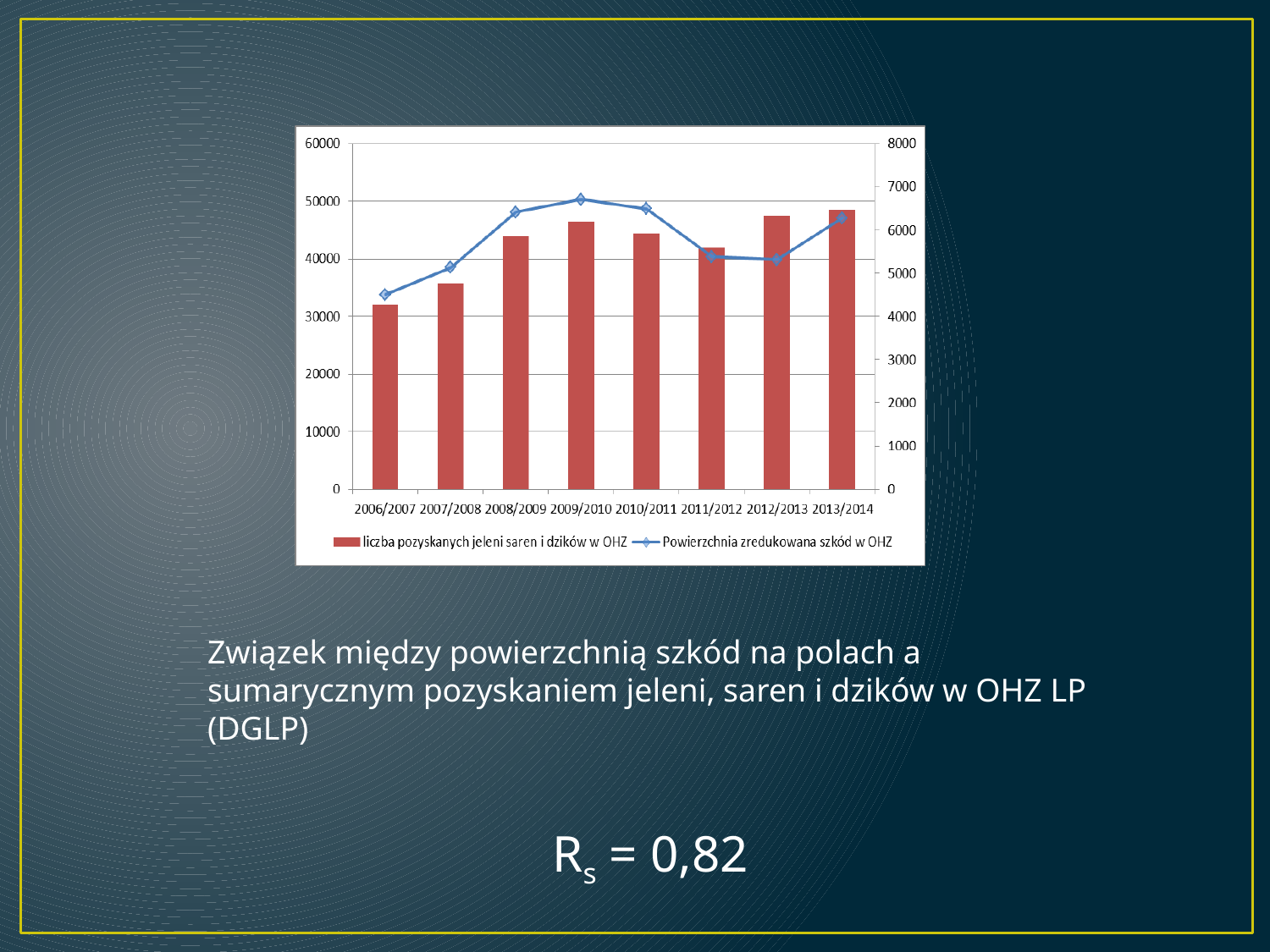
Which season has the highest bar for 'liczba pozyskanych jeleni saren i dzików w OHZ'? 2013/2014 Is the bar value for 2006/2007 greater or less than 30000? greater How many seasons (categories) are shown on the x axis of the chart? 8 Which season has the lowest bar for 'liczba pozyskanych jeleni saren i dzików w OHZ'? 2006/2007 Is the line value for 'Powierzchnia zredukowana szkód w OHZ' in 2006/2007 greater or less than 5000 on the right axis? less What kind of chart is shown on the slide? Combined bar and line chart How many series does the chart legend list? 2 Do the bar values rise or fall from 2006/2007 to 2009/2010? rise In which season does the line 'Powierzchnia zredukowana szkód w OHZ' have its lowest point? 2006/2007 Is the line value for 'Powierzchnia zredukowana szkód w OHZ' in 2009/2010 greater or less than 6000 on the right axis? greater In which season does the line 'Powierzchnia zredukowana szkód w OHZ' reach its highest point? 2009/2010 Which season has a taller bar, 2008/2009 or 2007/2008? 2008/2009